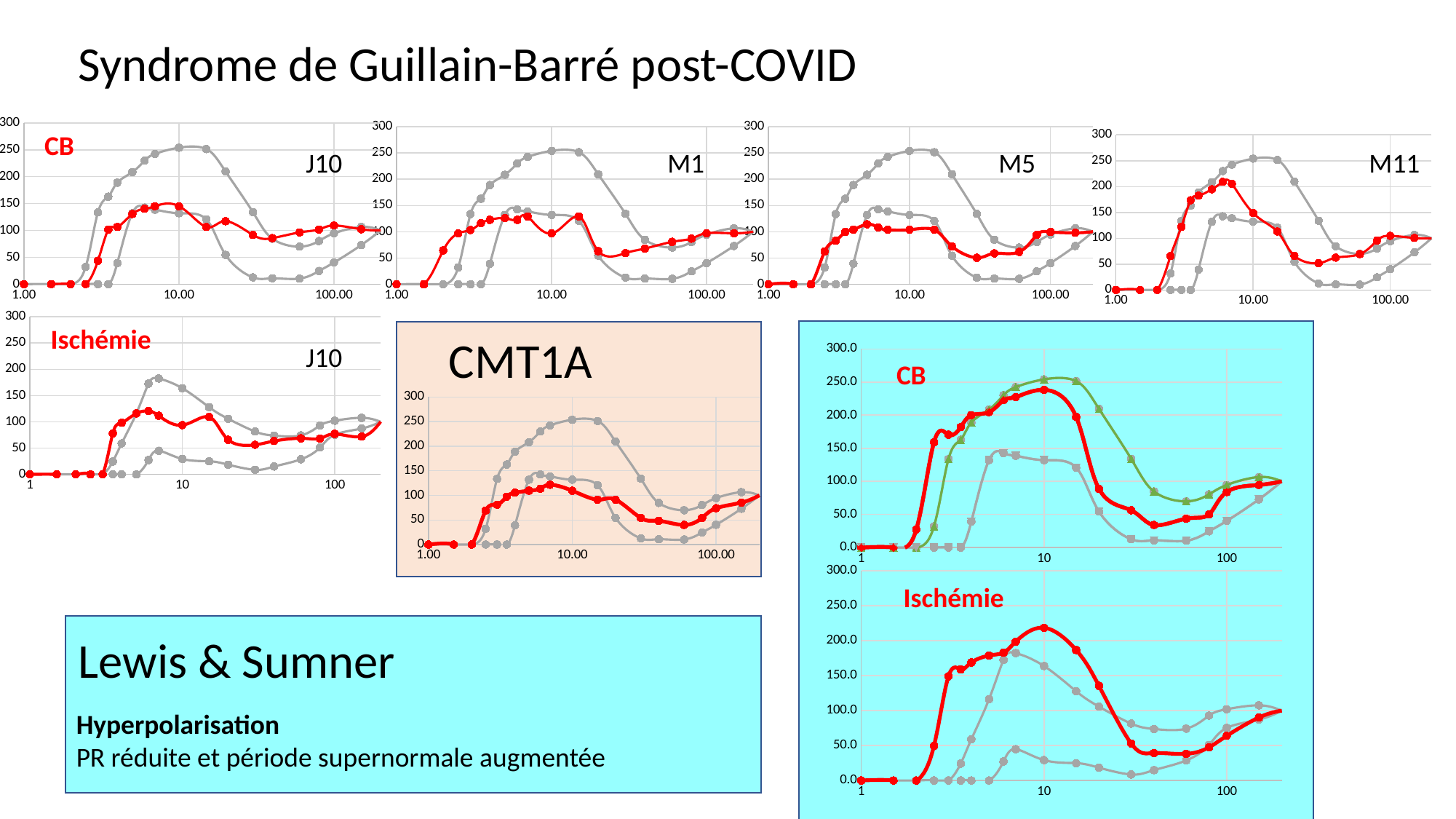
In the CB M11 chart (top right), is the peak value of the red line greater or less than 150? greater How many lines are plotted in the CMT1A chart? 3 What is the highest value shown on the y axis of the CB J10 chart? 300 In the CB J10 chart (top left), is the peak value of the red line greater or less than 200? less What is the title of the slide? Syndrome de Guillain-Barré post-COVID In the CB M11 chart (top right), does the red line rise or fall between x = 10 and x = 30? fall What kind of chart is the CB J10 chart at the top left of the slide? line chart In the Ischémie chart inside the cyan box at the bottom right, is the peak value of the red line greater or less than 150? greater How many charts are in the top row of the slide? 4